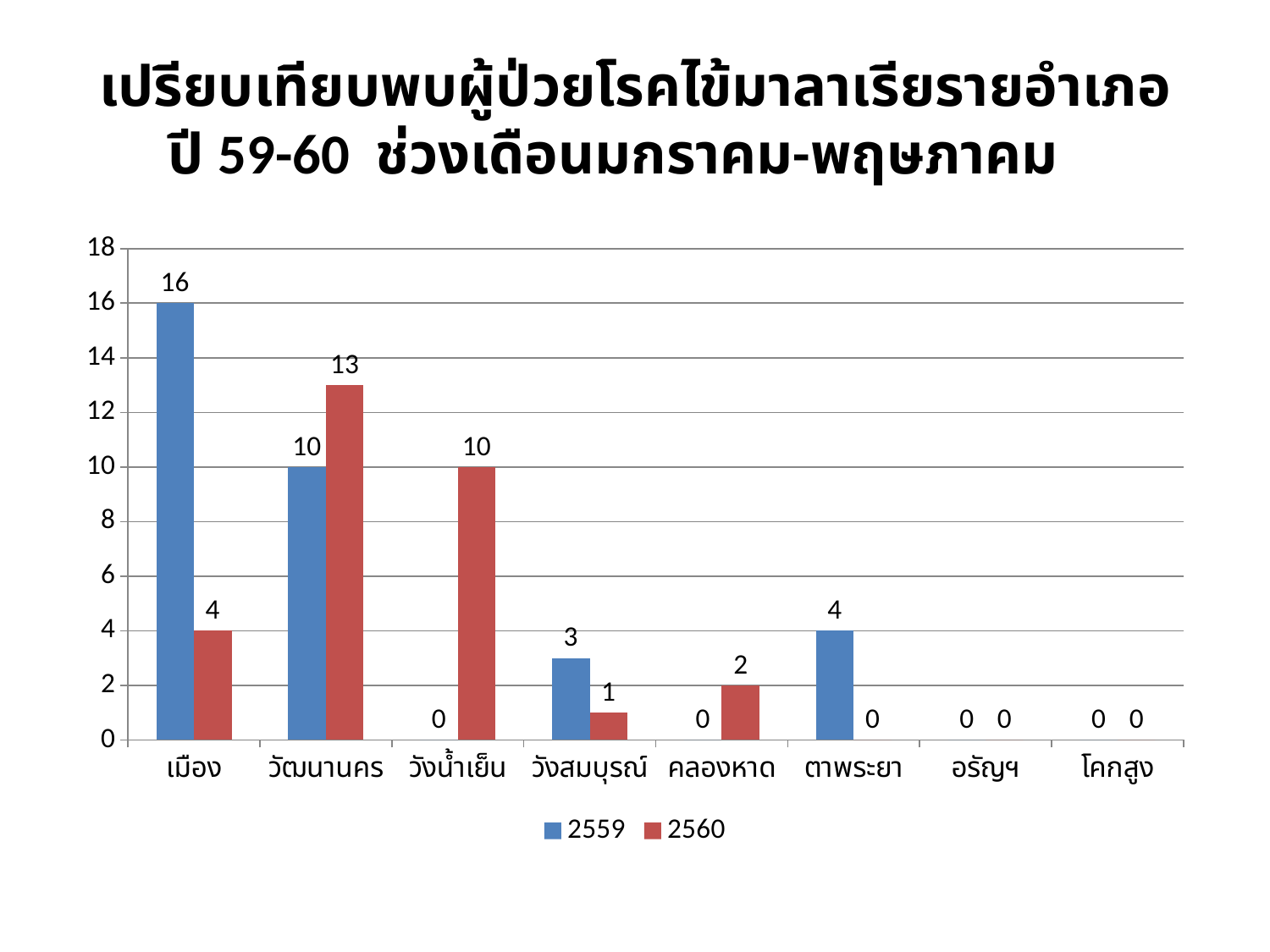
What is the value for คลองหาด in the 2560 series? 2 What is the value for วัฒนานคร in the 2560 series? 13 Which is larger for วัฒนานคร, the 2559 value or the 2560 value? 2560 What is the value for วังน้ำเย็น in the 2559 series? 0 How many series does the legend list? 2 What is the value for เมือง in the 2559 series? 16 Which category has the highest value in the 2560 series? วัฒนานคร How many categories are shown on the x axis? 8 Which category has the highest value in the 2559 series? เมือง What is the difference between the 2559 and 2560 values for เมือง? 12 What kind of chart is shown on the slide? bar chart What is the total of the 2559 and 2560 values for วังสมบูรณ์? 4